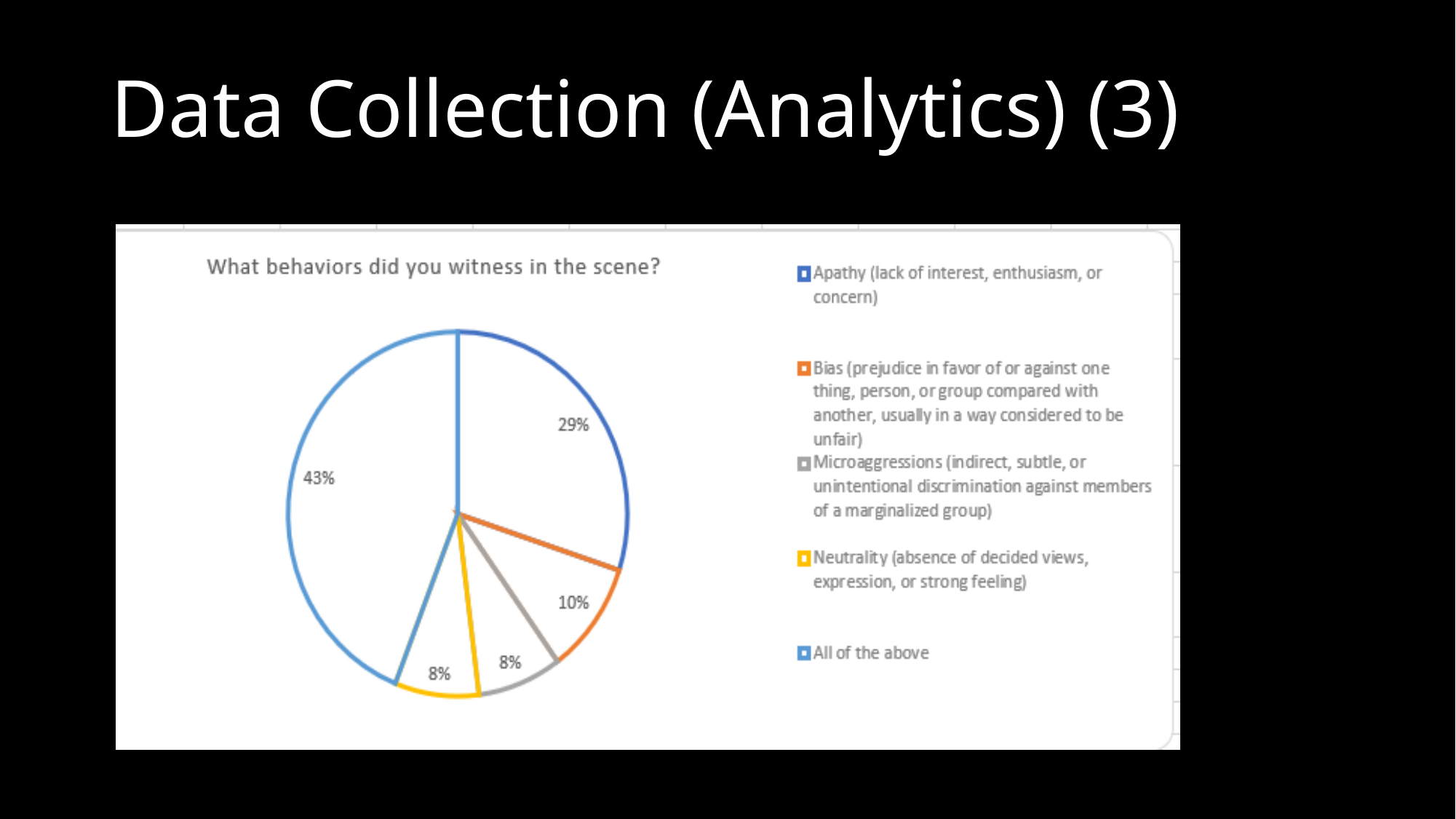
What percentage of the pie is the 'Bias' slice? 10% What is the difference in percentage points between the 'All of the above' slice and the 'Apathy' slice? 14 Which is larger, the 'Apathy' slice or the 'Bias' slice? Apathy What percentage of the pie is the 'Neutrality' slice? 8% What percentage of the pie is the 'Apathy' slice? 29% What percentage of the pie is the 'All of the above' slice? 43% What kind of chart is shown on the slide? Pie chart What is the combined percentage of the 'Microaggressions' and 'Neutrality' slices? 16% What is the title of the chart? What behaviors did you witness in the scene? How many entries does the legend list? 5 Which category has the largest slice of the pie? All of the above How many slices does the pie chart have? 5